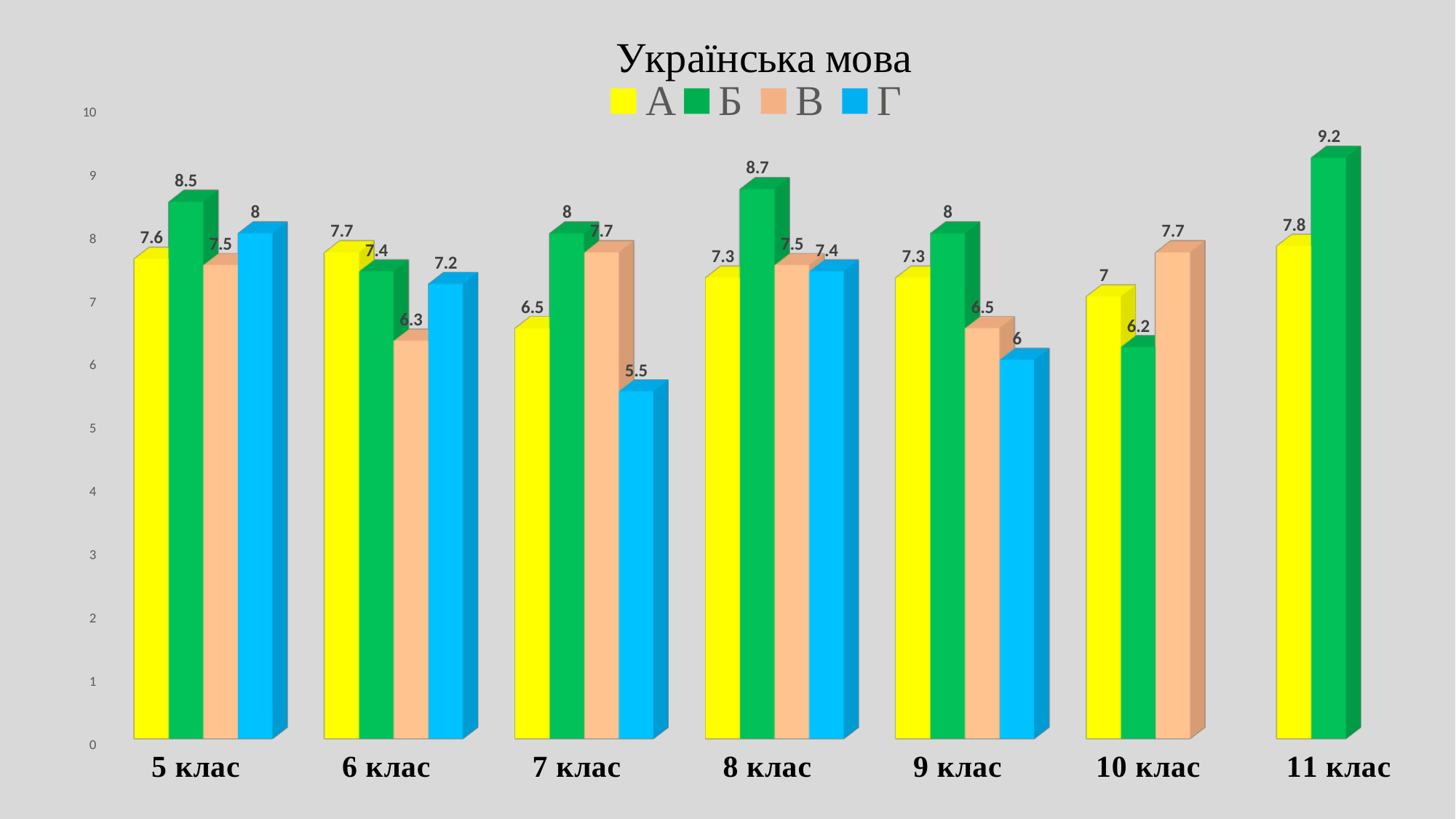
In 10 клас, which is larger: the value for В or the value for Б? В What is the value for Б in 11 клас? 9.2 How many series does the legend list? 4 Which class has the highest value for series Б? 11 клас How many classes (categories) are shown on the x axis? 7 What is the value for Г in 7 клас? 5.5 Which class has the lowest value for series Г? 7 клас What is the value for А in 10 клас? 7 What kind of chart is shown on the slide? bar chart What is the value for В in 6 клас? 6.3 What is the title of the chart? Українська мова What is the difference between Б and А in 8 клас? 1.4